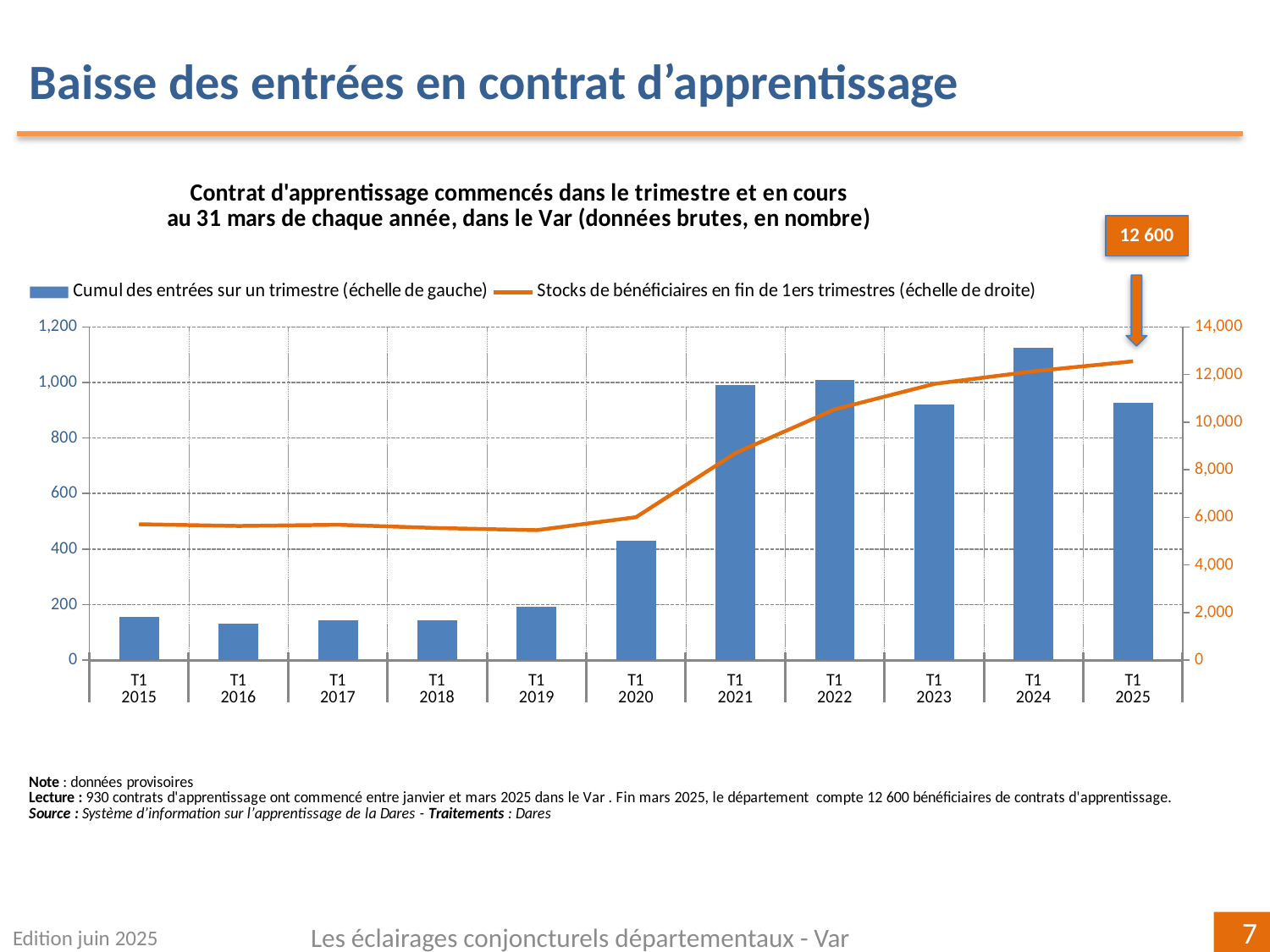
What is the value of the stock of beneficiaries (Stocks de bénéficiaires) at T1 2025? 12 600 What kind of chart is shown on the slide? A combined bar and line chart Which bar is taller, T1 2023 or T1 2024? T1 2024 How many quarters (categories) are shown on the x axis? 11 How many series does the legend list? 2 In which quarter is the bar for 'Cumul des entrées sur un trimestre' the highest? T1 2024 Does the line for 'Stocks de bénéficiaires' rise or fall between T1 2019 and T1 2025? It rises Is the stock of beneficiaries at T1 2015 greater or less than 8,000? less Is the bar value for T1 2020 greater or less than 600? less Is the bar value for T1 2021 greater or less than 800? greater Which series is plotted on the right-hand axis (échelle de droite)? Stocks de bénéficiaires en fin de 1ers trimestres